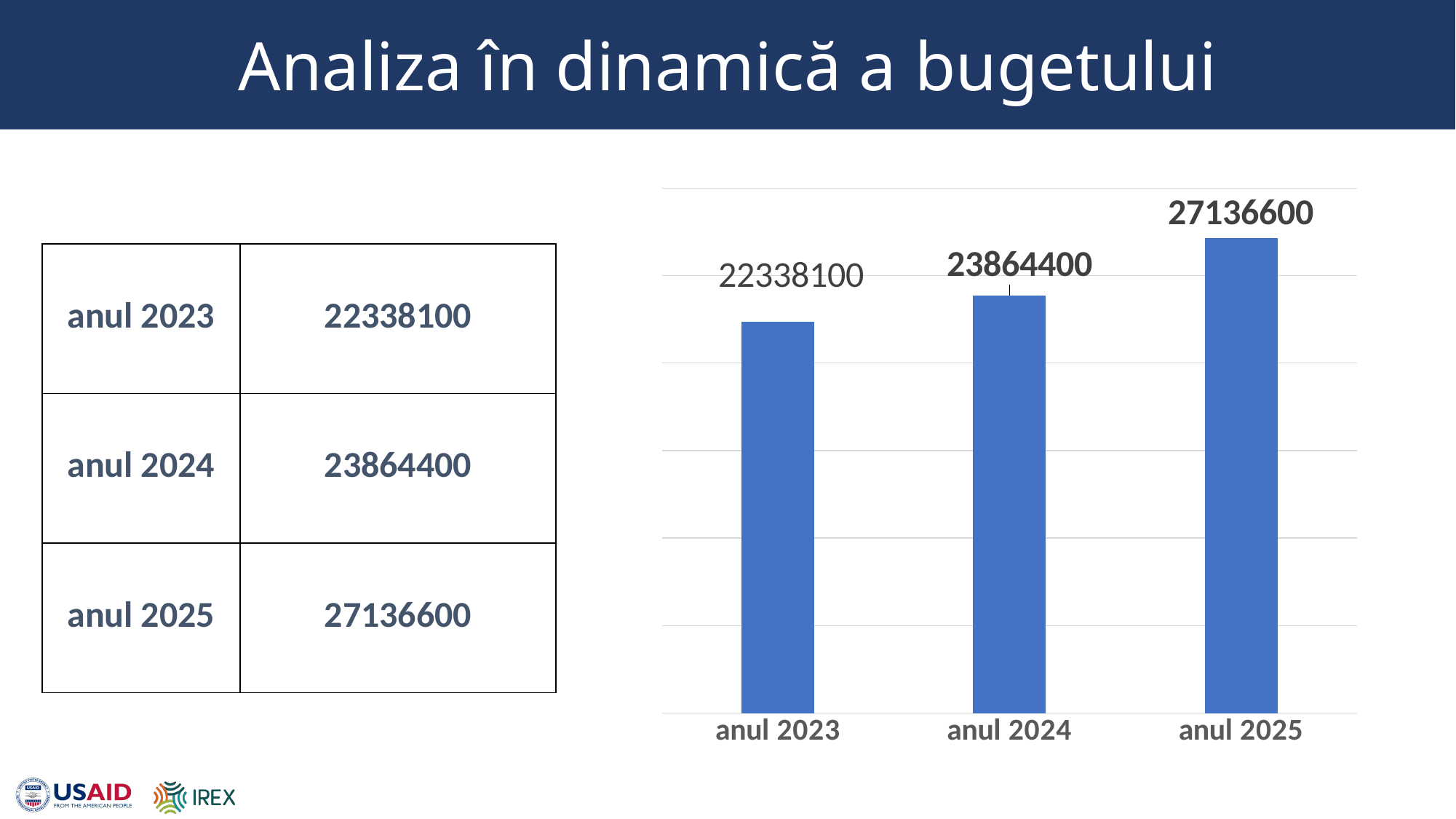
Which is larger, the value for anul 2024 or the value for anul 2023? anul 2024 What is the value for anul 2024 in the chart? 23864400 What is the title of the slide containing the chart? Analiza în dinamică a bugetului What is the difference between the values for anul 2024 and anul 2023? 1526300 Which year has the lowest value in the chart? anul 2023 How many bars are shown in the chart? 3 Which year has the highest value in the chart? anul 2025 What is the value for anul 2025 in the chart? 27136600 What is the difference between the values for anul 2025 and anul 2024? 3272200 What kind of chart is shown on the slide? bar chart What is the value for anul 2023 in the chart? 22338100 Do the values rise or fall from anul 2023 to anul 2025? rise